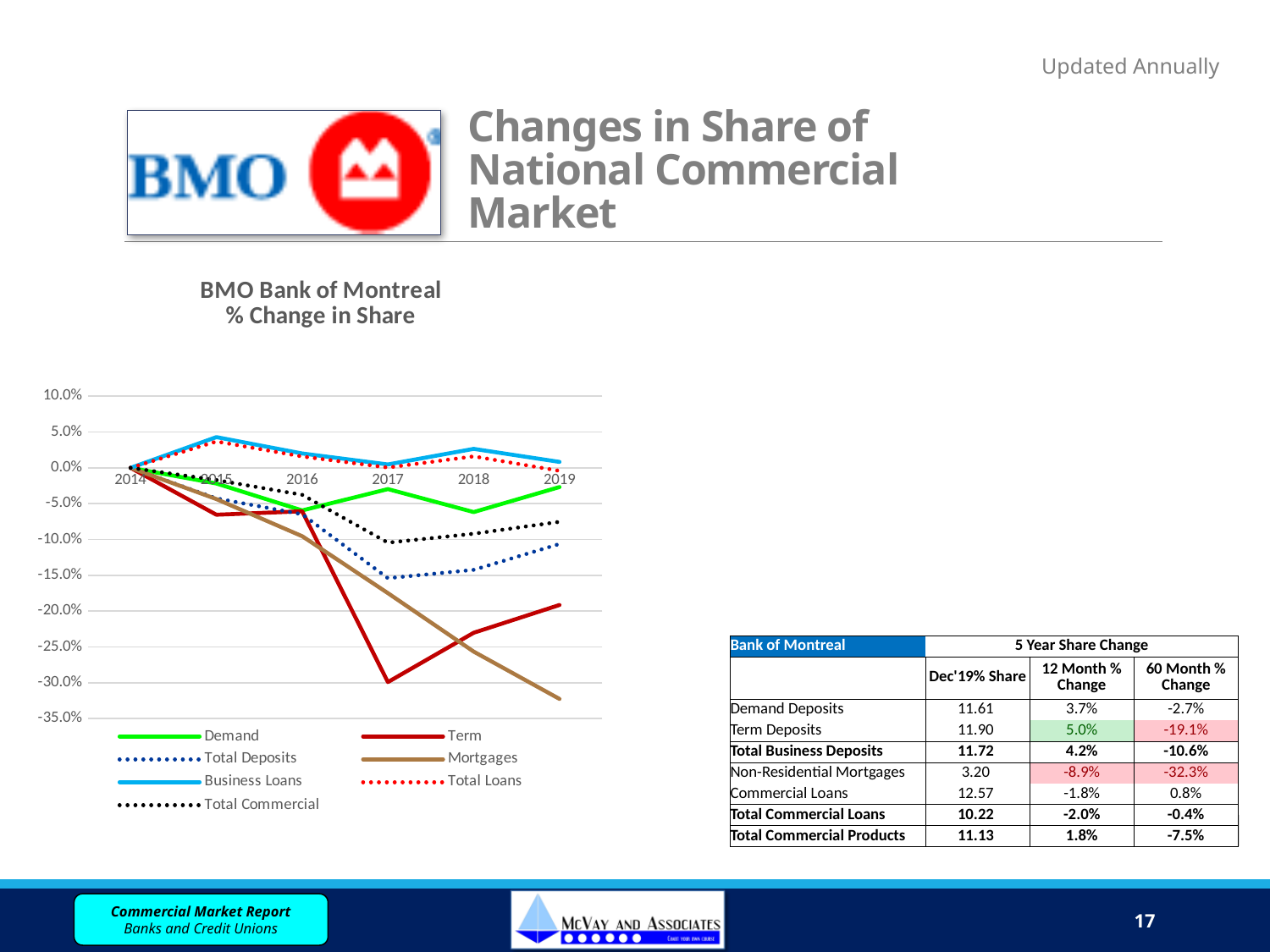
Does the Mortgages series rise or fall from 2014 to 2019? fall How many years are plotted along the x axis of the chart? 6 Which series has the lowest value in 2019? Mortgages What kind of chart is shown on the slide? line chart Is the value for Demand in 2019 greater or less than -5.0%? greater How many series does the chart's legend list? 7 Which series has the lowest value in 2017? Term In 2019, which is higher: Term or Mortgages? Term Is the value for Mortgages in 2019 greater or less than -25.0%? less What is the title of the chart? BMO Bank of Montreal % Change in Share Is the value for Term in 2017 greater or less than -25.0%? less